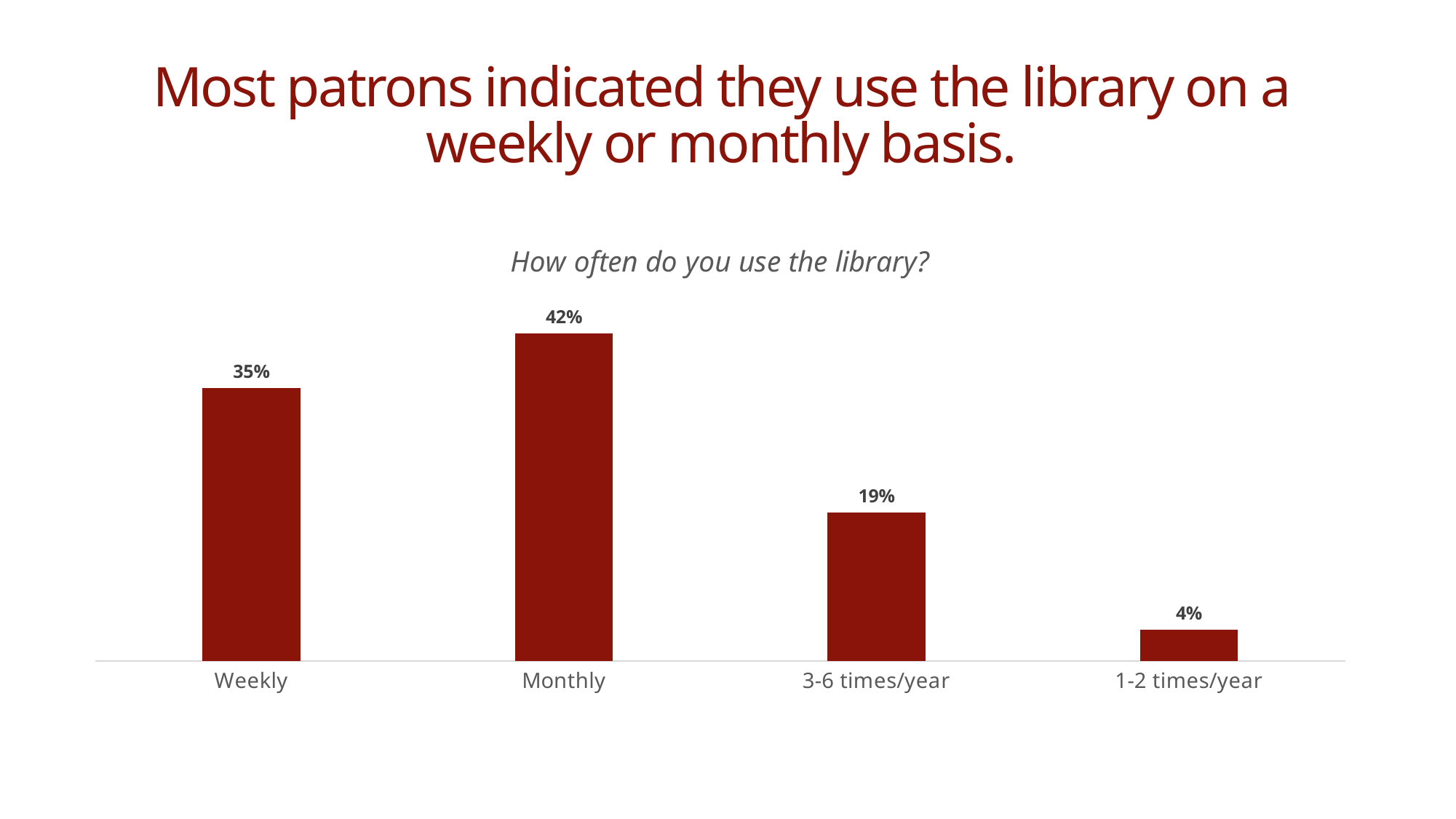
What kind of chart is shown on the slide? Bar chart What is the difference between the Monthly and Weekly values? 7% How many categories are shown on the chart? 4 Which category has the highest value? Monthly What is the value for 1-2 times/year? 4% What percentage of patrons said they use the library weekly? 35% Which category has the lowest value? 1-2 times/year What is the difference between the 3-6 times/year and 1-2 times/year values? 15% Which is larger, the value for Weekly or the value for 3-6 times/year? Weekly What is the value for 3-6 times/year? 19% What percentage of patrons said they use the library monthly? 42% What is the title of the chart? How often do you use the library?